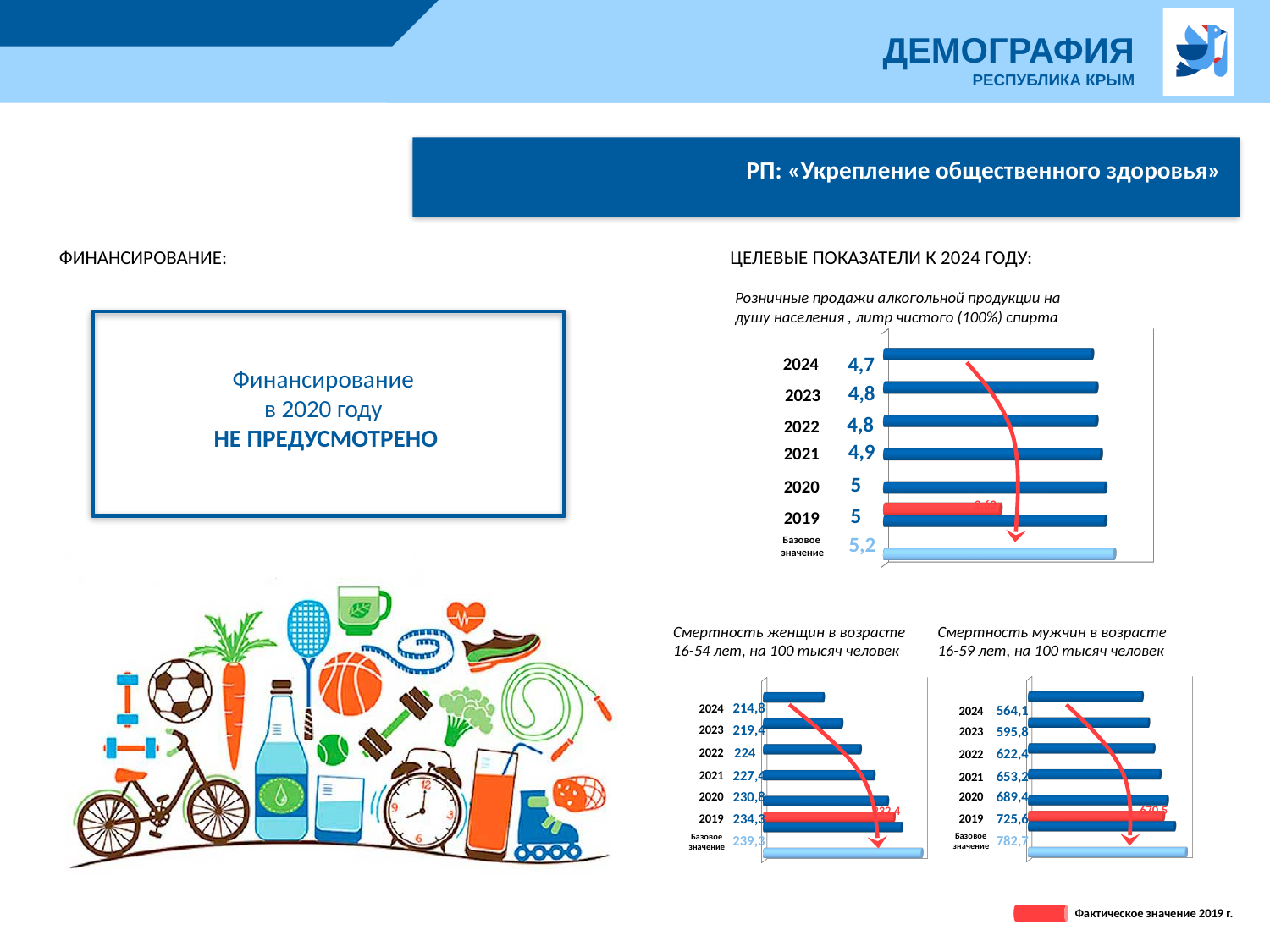
In the chart 'Смертность мужчин в возрасте 16-59 лет', what is the difference between the 2019 and 2024 values? 161,5 In the chart 'Смертность мужчин в возрасте 16-59 лет', what is the value for 2021? 653,2 In the chart 'Розничные продажи алкогольной продукции на душу населения', what is the value for 2024? 4,7 In the chart 'Смертность женщин в возрасте 16-54 лет', what is the difference between the 2019 and 2024 values? 19,5 In the chart 'Розничные продажи алкогольной продукции на душу населения', what is the difference between the 'Базовое значение' and the 2024 value? 0,5 In the chart 'Смертность женщин в возрасте 16-54 лет', what is the value for 2022? 224 In the chart 'Смертность мужчин в возрасте 16-59 лет', do the values rise or fall from 2019 to 2024? fall In the chart 'Розничные продажи алкогольной продукции на душу населения', what is the 'Базовое значение'? 5,2 In the chart 'Смертность мужчин в возрасте 16-59 лет', which is larger, the value for 2020 or the value for 2023? 2020 In the chart 'Смертность женщин в возрасте 16-54 лет', which category has the highest value? Базовое значение What kind of chart is 'Смертность женщин в возрасте 16-54 лет'? bar chart